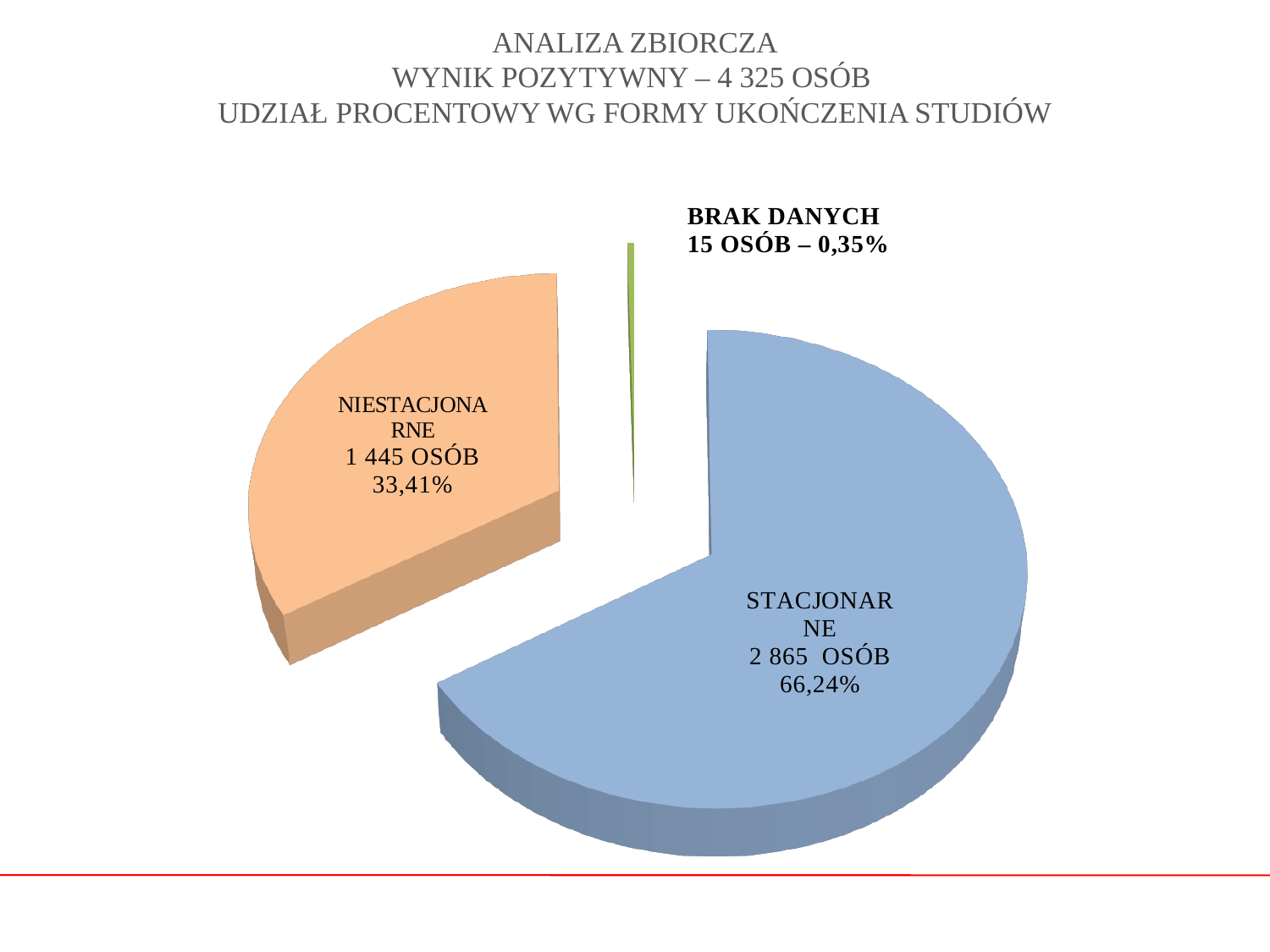
What is the difference in number of people between STACJONARNE and NIESTACJONARNE? 1 420 What colour is the STACJONARNE slice? Blue How many people (OSÓB) are in the NIESTACJONARNE slice? 1 445 How many slices does the pie chart have? 3 Which slice is larger, NIESTACJONARNE or BRAK DANYCH? NIESTACJONARNE What is the total number of people (OSÓB) with a positive result given in the chart title? 4 325 What percentage share does the BRAK DANYCH slice have? 0,35% Which slice of the pie chart is the largest? STACJONARNE Which slice of the pie chart is the smallest? BRAK DANYCH What kind of chart is shown on the slide? Pie chart What percentage share does the STACJONARNE slice have? 66,24% How many people (OSÓB) are in the BRAK DANYCH slice? 15